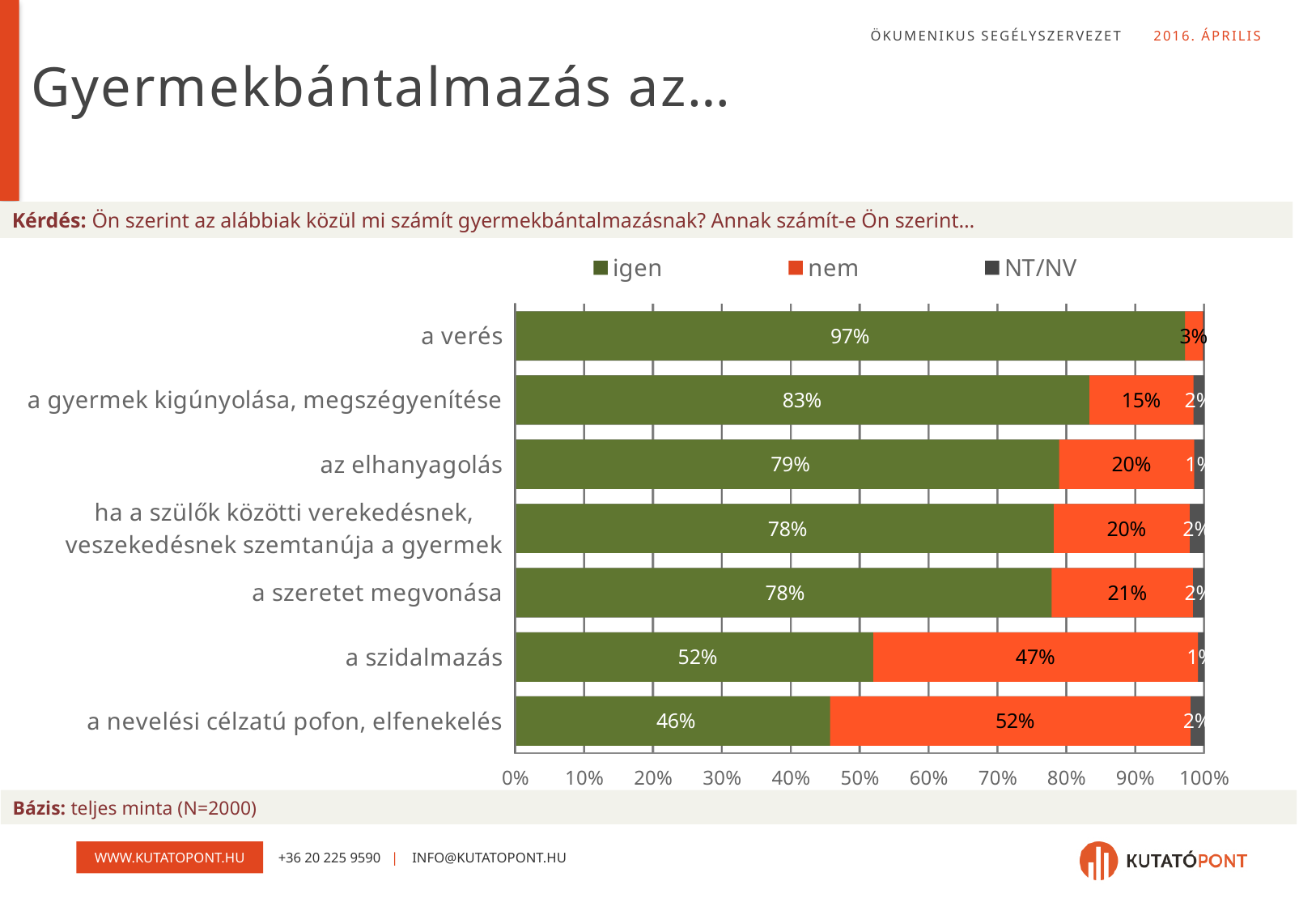
Which category has the highest 'igen' value? a verés Which is larger: the 'nem' value for 'a szidalmazás' or the 'nem' value for 'a szeretet megvonása'? a szidalmazás What kind of chart is shown on the slide? stacked bar chart Which category has the lowest 'igen' value? a nevelési célzatú pofon, elfenekelés What is the 'igen' value for 'a verés'? 97% What is the 'NT/NV' value for 'az elhanyagolás'? 1% What is the 'igen' value for 'a nevelési célzatú pofon, elfenekelés'? 46% How many series does the legend list? 3 How many categories are plotted on the chart? 7 What is the difference between the 'igen' values for 'a gyermek kigúnyolása, megszégyenítése' and 'az elhanyagolás'? 4% What is the 'nem' value for 'a szidalmazás'? 47% Which series is shown in green in the legend? igen